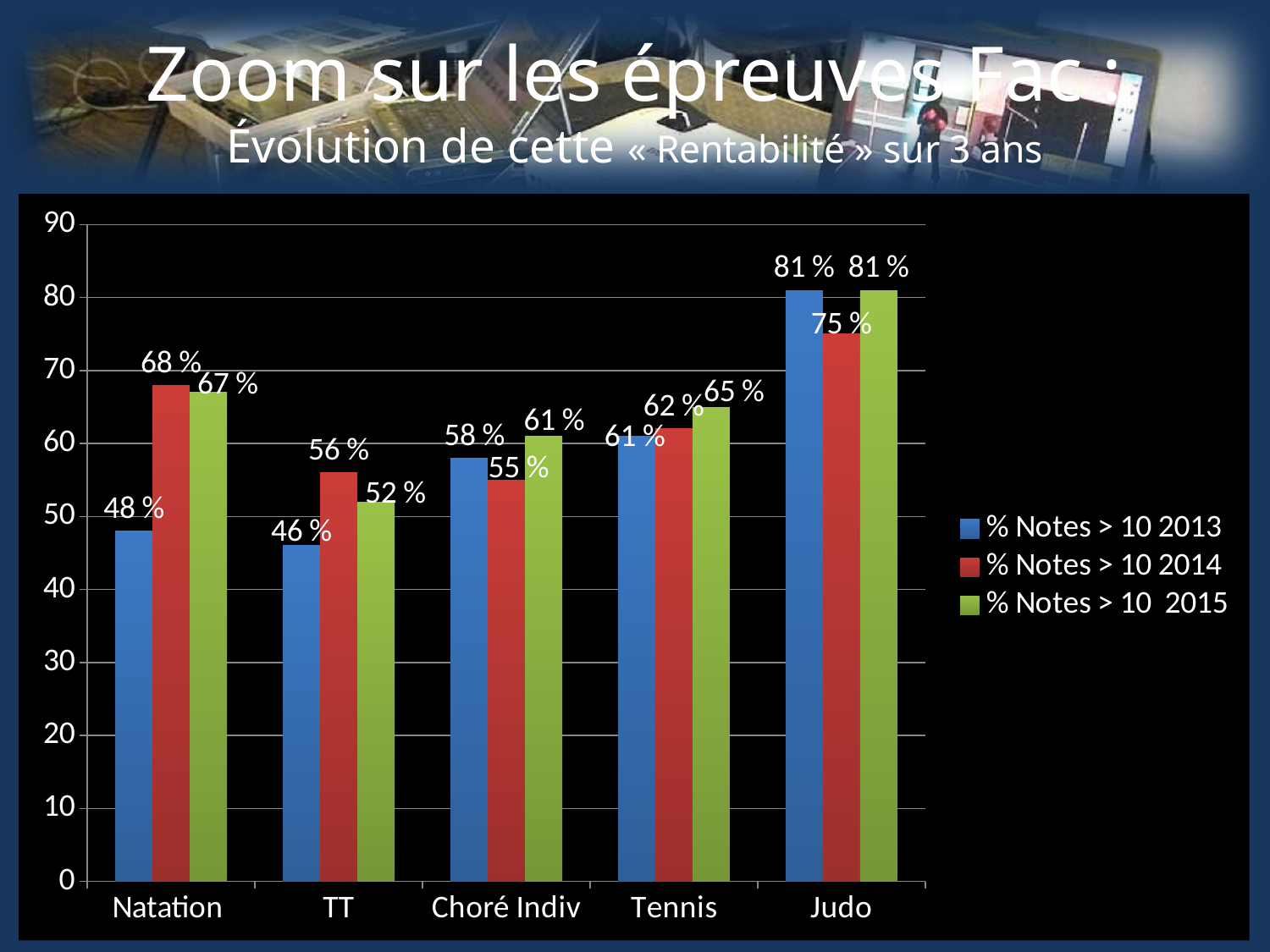
What is the difference between the Judo and Tennis values in the % Notes > 10 2015 series? 16 % What is the value for Choré Indiv in the % Notes > 10 2015 series? 61 % Which category has the lowest value in the % Notes > 10 2015 series? TT What is the value for Judo in the % Notes > 10 2014 series? 75 % What is the value for Natation in the % Notes > 10 2014 series? 68 % For Choré Indiv, which is larger: the % Notes > 10 2013 value or the % Notes > 10 2014 value? % Notes > 10 2013 How many categories are shown on the x axis? 5 What is the difference between the % Notes > 10 2014 and % Notes > 10 2013 values for Natation? 20 % What is the value for TT in the % Notes > 10 2013 series? 46 % What kind of chart is shown on the slide? Bar chart Which category has the highest value in the % Notes > 10 2013 series? Judo How many series does the legend list? 3